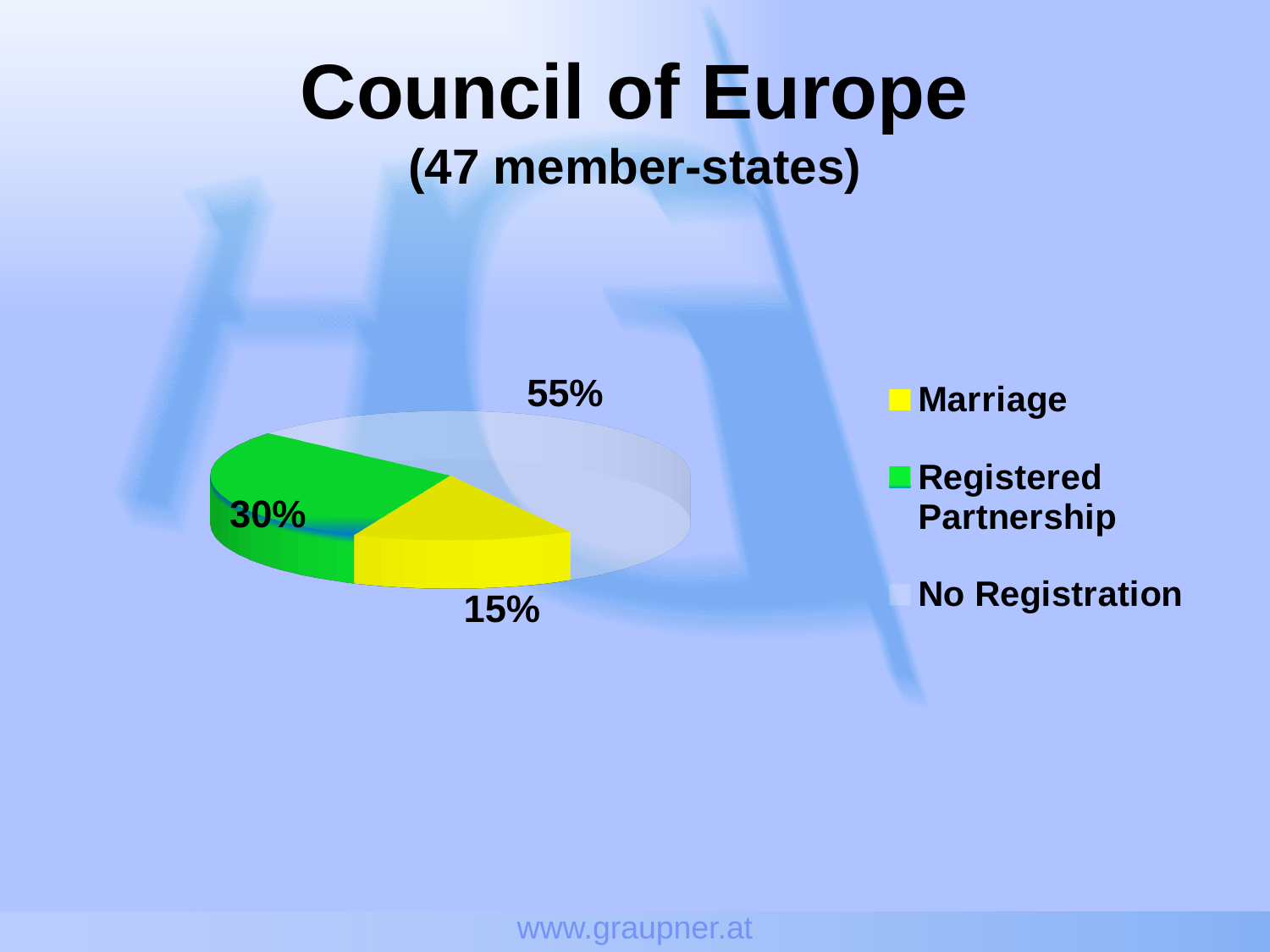
What is the difference in percentage points between Registered Partnership and Marriage? 15 Which category has the largest slice of the pie? No Registration Which is larger, the Marriage slice or the Registered Partnership slice? Registered Partnership What share of the pie is labelled Registered Partnership? 30% What share of the pie is labelled Marriage? 15% What kind of chart is shown on the slide? pie chart How many slices does the pie chart have? 3 How many entries does the legend list? 3 Which category has the smallest slice of the pie? Marriage What share of the pie is labelled No Registration? 55% What is the difference in percentage points between No Registration and Registered Partnership? 25 What colour is the Marriage slice in the pie chart? yellow